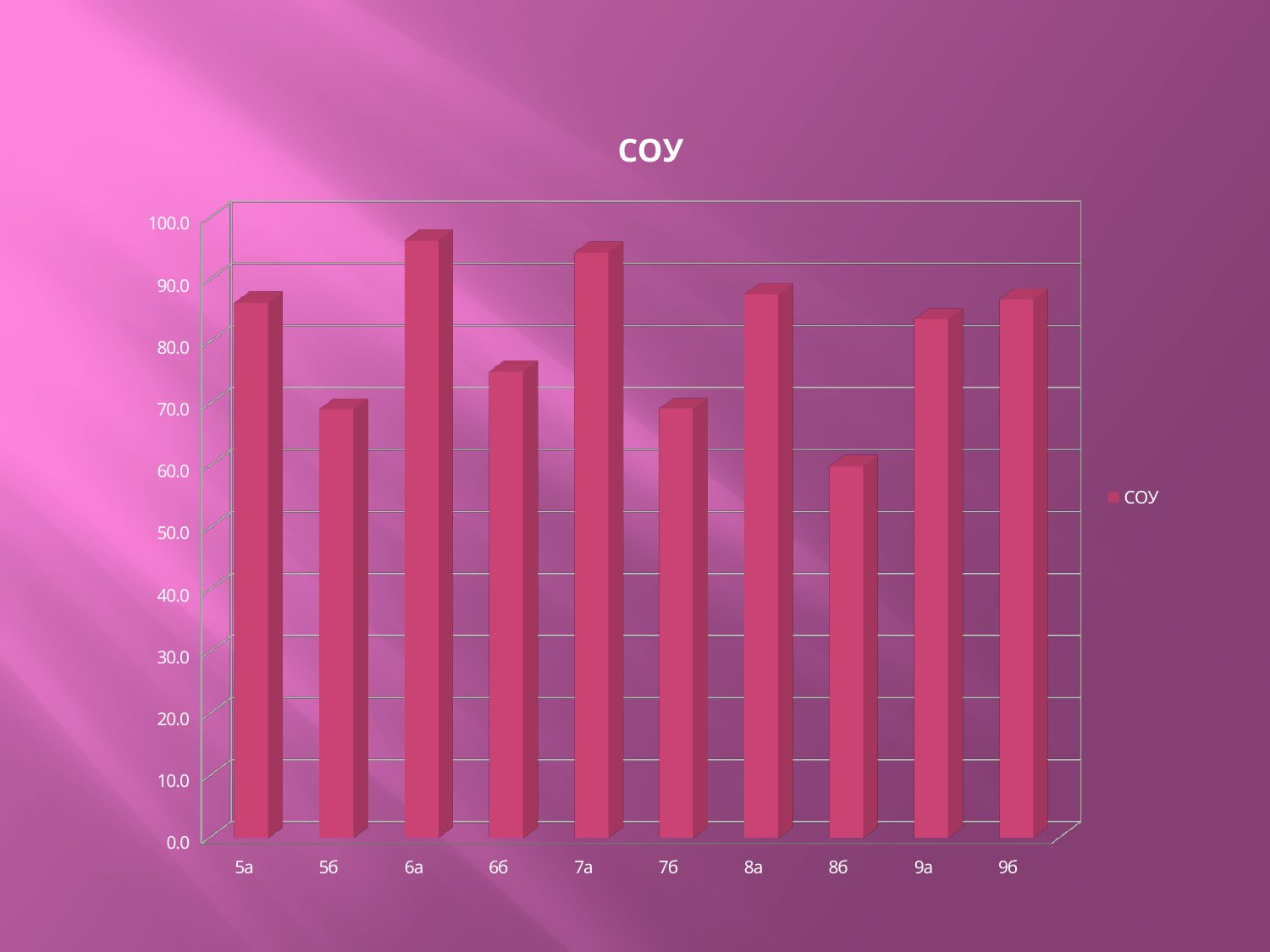
How many series does the legend list? 1 Is the value for 6б greater or less than 70? greater What kind of chart is shown on the slide? bar chart Is the value for 6а greater or less than 90? greater Which is larger, the value for 5б or the value for 6б? 6б Is the value for 8б greater or less than 70? less What is the title of the chart? СОУ Which category has the lowest value? 8б Which is larger, the value for 8б or the value for 9а? 9а How many categories are shown on the x axis of the chart? 10 Which category has the highest value? 6а